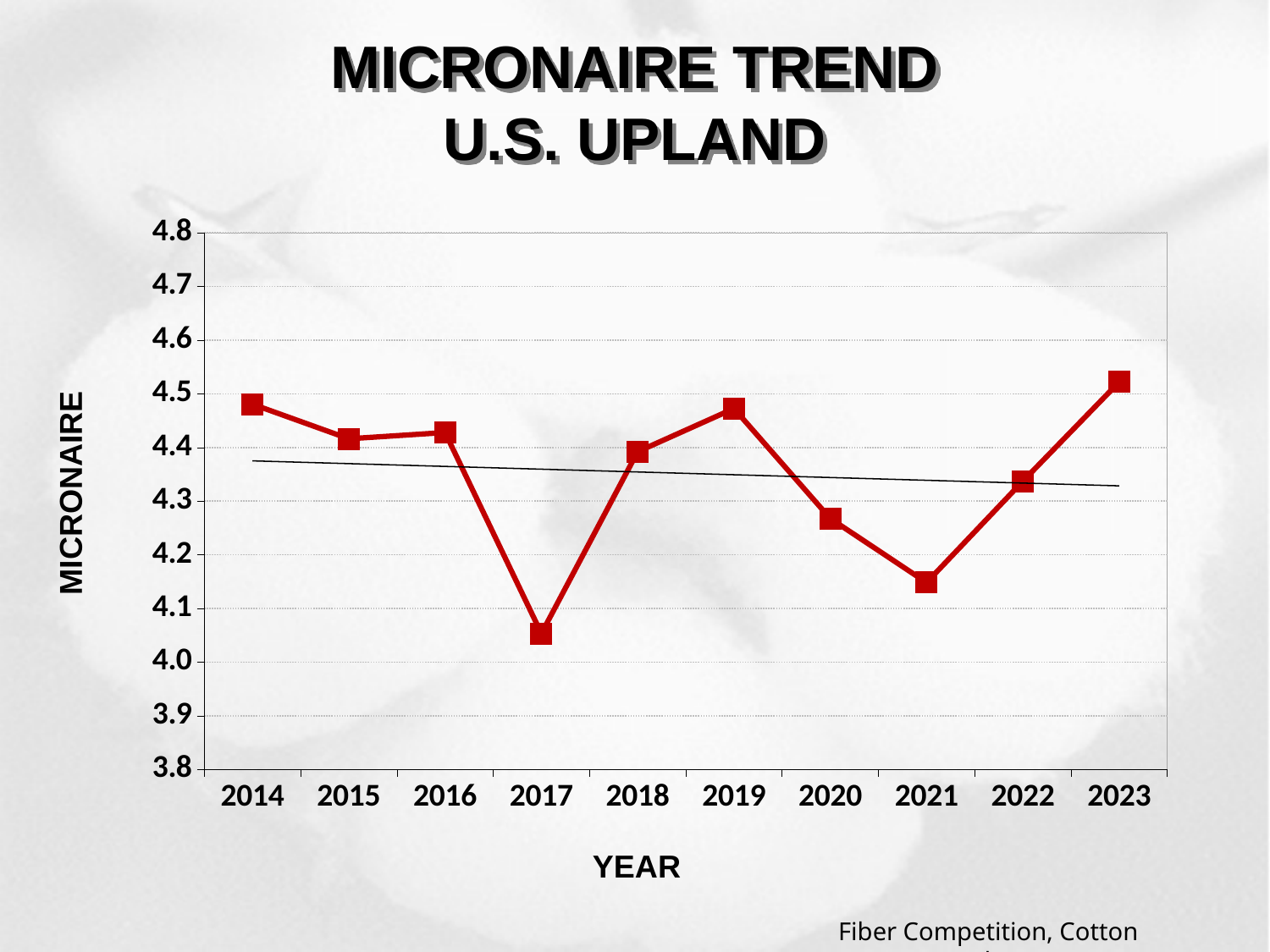
Which year has the lowest micronaire value? 2017 Is the micronaire value for 2017 greater or less than 4.1? less What kind of chart is shown on the slide? line chart Which year has the highest micronaire value? 2023 What is the label on the y axis? MICRONAIRE Is the micronaire value for 2021 greater or less than 4.2? less Which year has the larger micronaire value, 2018 or 2020? 2018 Do the micronaire values rise or fall from 2019 to 2021? fall What is the title of the chart? MICRONAIRE TREND U.S. UPLAND How many years are plotted on the x axis? 10 Is the micronaire value for 2014 greater or less than 4.4? greater